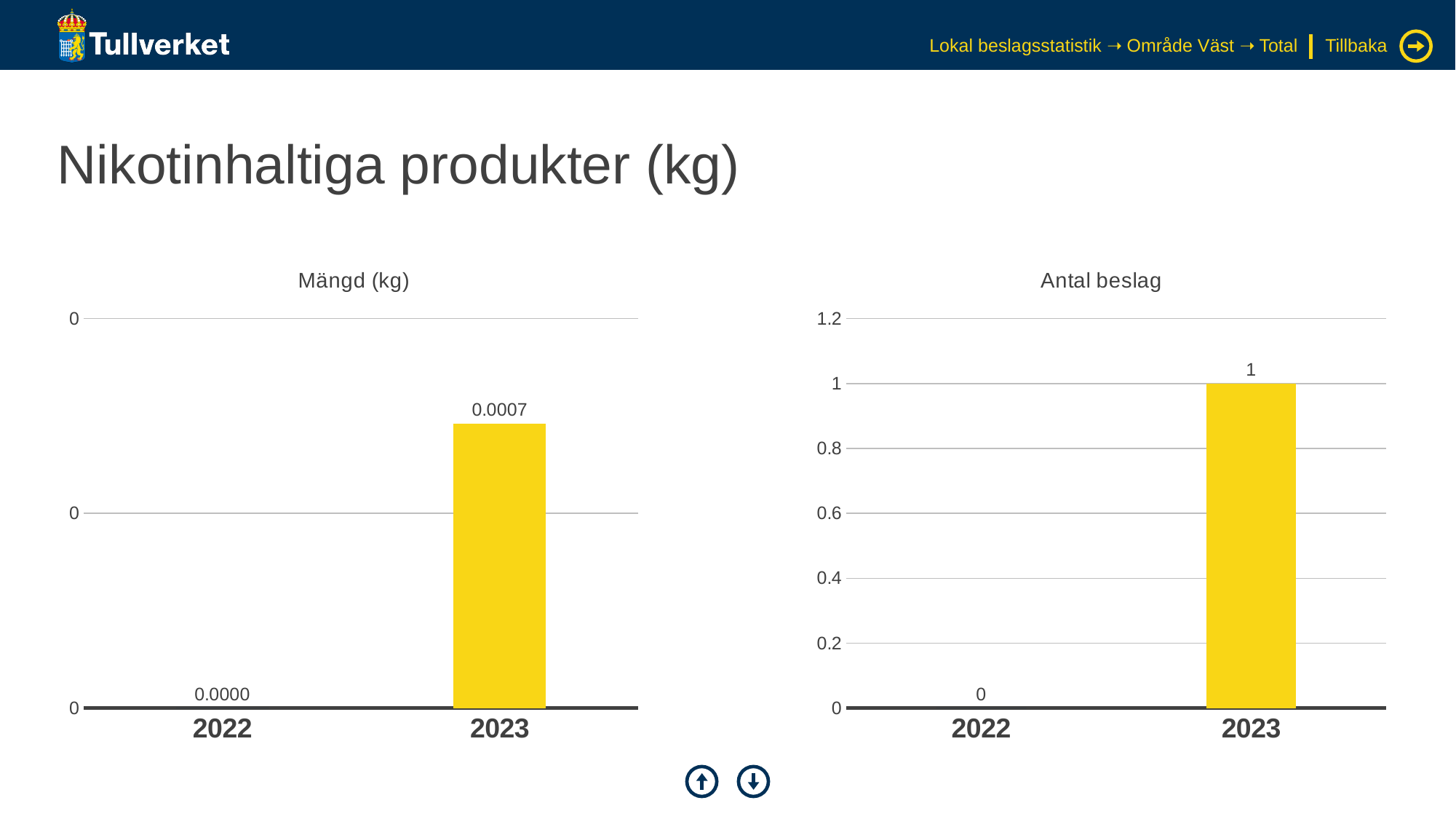
In the 'Mängd (kg)' chart, what is the value for 2022? 0.0000 In the 'Antal beslag' chart, what is the value for 2022? 0 In the 'Antal beslag' chart, do the values rise or fall from 2022 to 2023? Rise In the 'Mängd (kg)' chart, which year has the larger value, 2022 or 2023? 2023 In the 'Mängd (kg)' chart, what is the value for 2023? 0.0007 In the 'Antal beslag' chart, what is the difference between the values for 2023 and 2022? 1 What kind of chart is the 'Mängd (kg)' chart? Bar chart How many years are shown on the x axis of the 'Antal beslag' chart? 2 In the 'Mängd (kg)' chart, which year has the highest value? 2023 In the 'Antal beslag' chart, which year has the lowest value? 2022 In the 'Antal beslag' chart, what is the value for 2023? 1 What is the title of the chart on the right side of the slide? Antal beslag